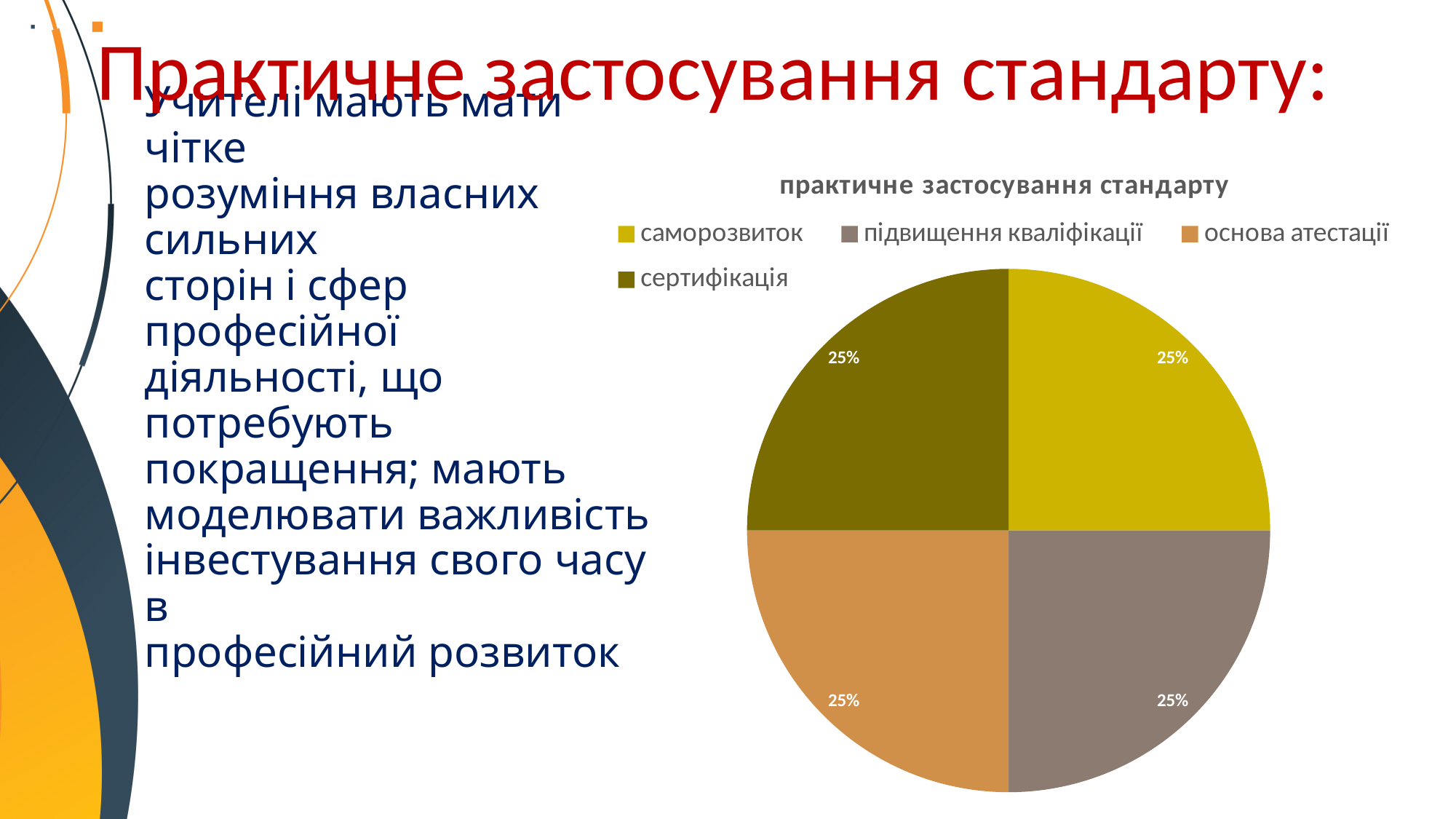
What share of the pie does сертифікація take? 25% What is the combined share of саморозвиток and основа атестації? 50% What is the value shown for підвищення кваліфікації? 25% How many entries does the chart legend list? 4 How many slices does the pie chart have? 4 What is the value shown for основа атестації? 25% Is the value for підвищення кваліфікації greater or less than 50%? less What share of the pie does саморозвиток take? 25% Which legend entry is shown in yellow? саморозвиток What is the difference between the values for саморозвиток and сертифікація? 0% What is the title of the chart? практичне застосування стандарту What type of chart is shown on the slide? pie chart